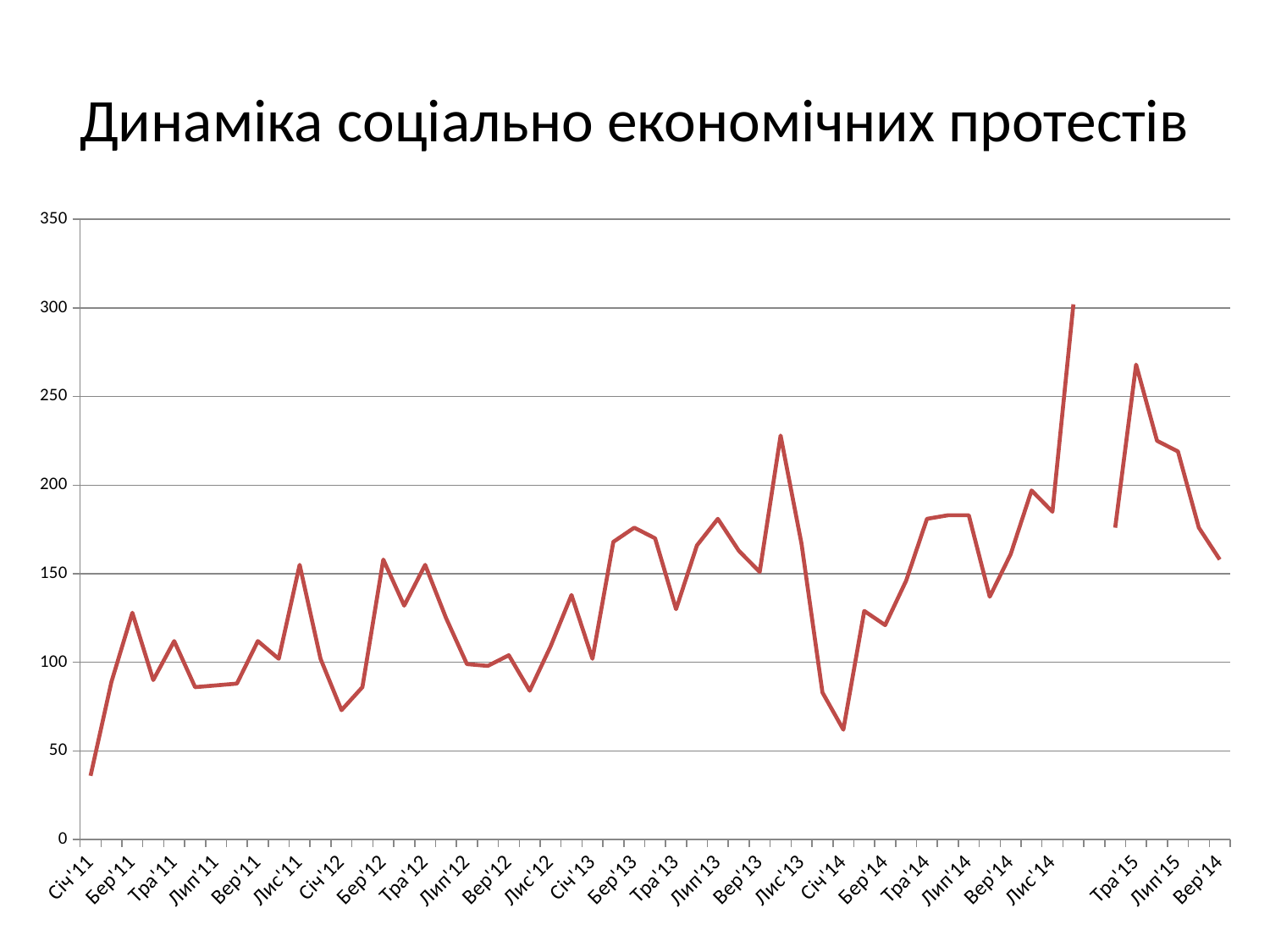
Is the highest point on the chart greater or less than 250? greater Is the value for Січ'11 greater or less than 50? less Which has the larger value, Січ'11 or Бер'11? Бер'11 What kind of chart is shown on the slide? line chart What is the title of the chart? Динаміка соціально економічних протестів Which has the larger value, Лис'13 or Січ'14? Лис'13 How many data series are plotted on the chart? 1 Is the value for Січ'14 greater or less than 100? less Overall, do the values rise or fall from Січ'11 to Лис'14? rise